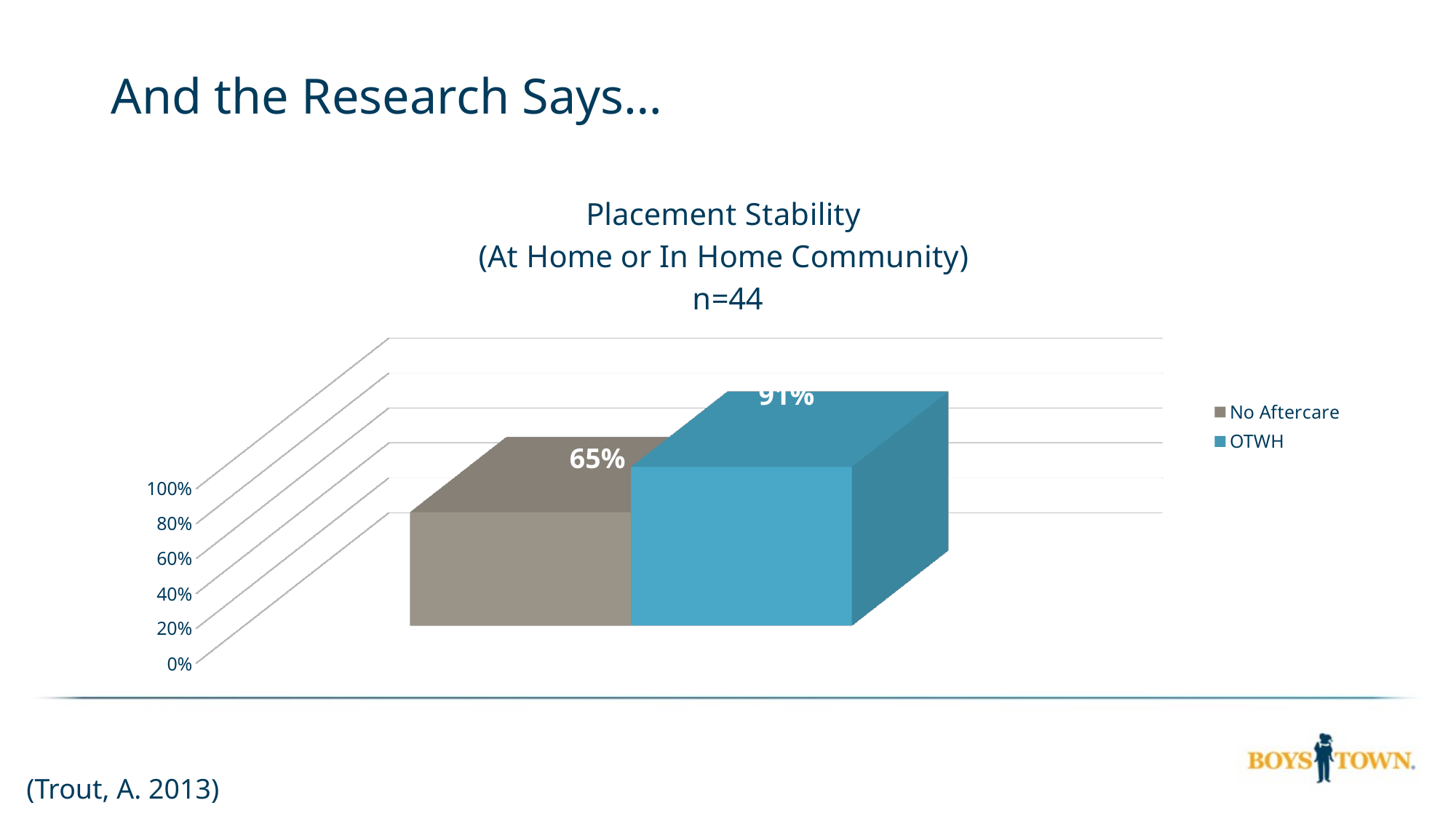
How many series does the legend list? 2 What is the value for OTWH? 91% Which series has the lower value? No Aftercare Is the value for OTWH greater or less than 80%? greater What kind of chart is shown on the slide? bar chart Which series has the higher value, No Aftercare or OTWH? OTWH What is the sample size shown in the chart title? n=44 Which legend entry is shown in blue? OTWH Is the value for No Aftercare greater or less than 80%? less What is the value for No Aftercare? 65% What is the difference between the OTWH value and the No Aftercare value? 26%